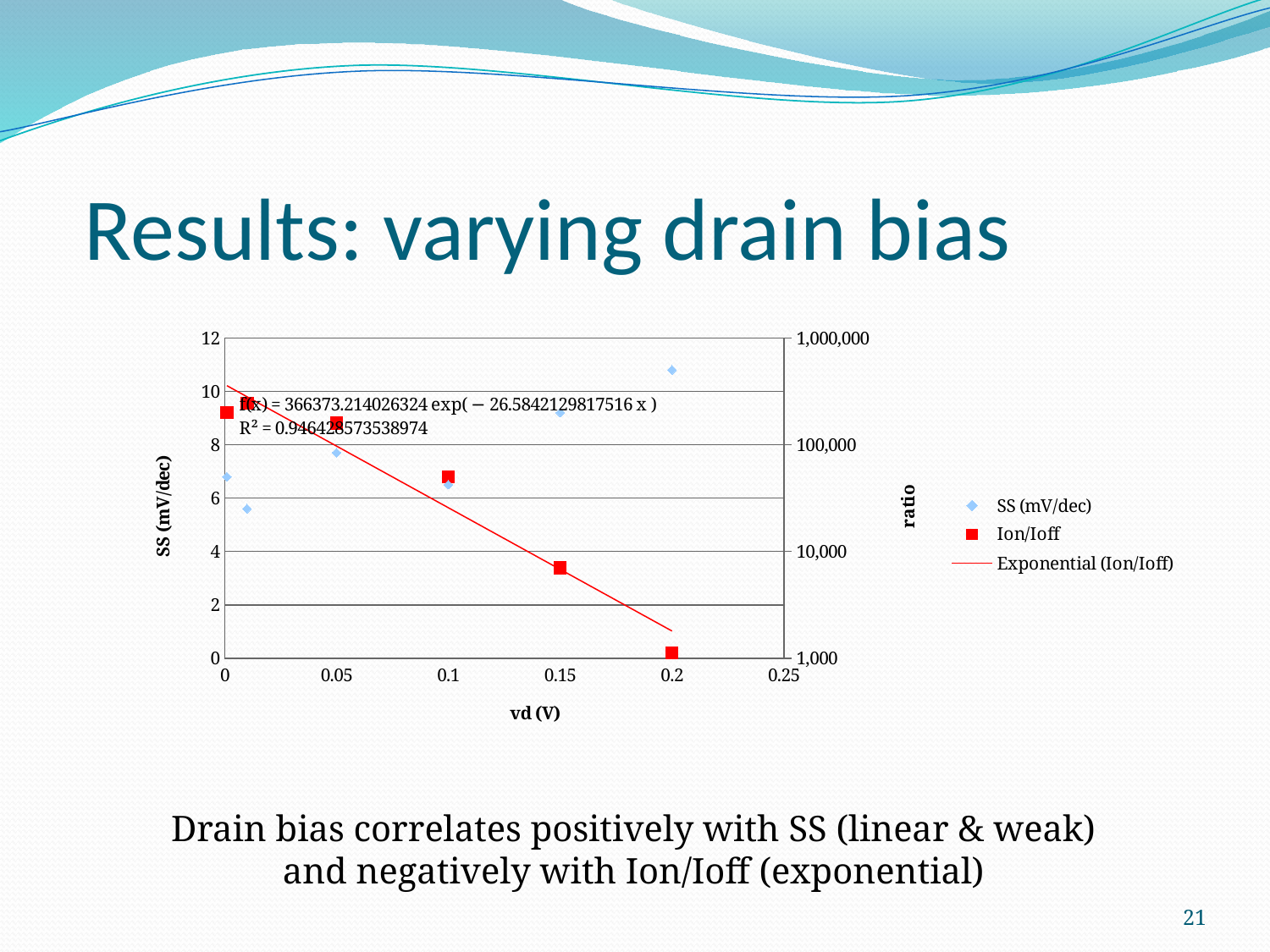
How many Ion/Ioff data points are plotted? 6 Which is larger, the Ion/Ioff value at vd = 0.1 or at vd = 0.15? vd = 0.1 At which vd value is the Ion/Ioff ratio lowest? 0.2 What is the title of the x axis? vd (V) Is the SS (mV/dec) value at vd = 0.2 greater or less than 10? greater What kind of chart is shown on the slide? scatter chart Does the Ion/Ioff ratio rise or fall as vd increases? fall At which vd value is SS (mV/dec) highest? 0.2 How many series does the legend list? 3 Is the Ion/Ioff value at vd = 0.2 greater or less than 10,000? less What is the third entry in the legend? Exponential (Ion/Ioff)